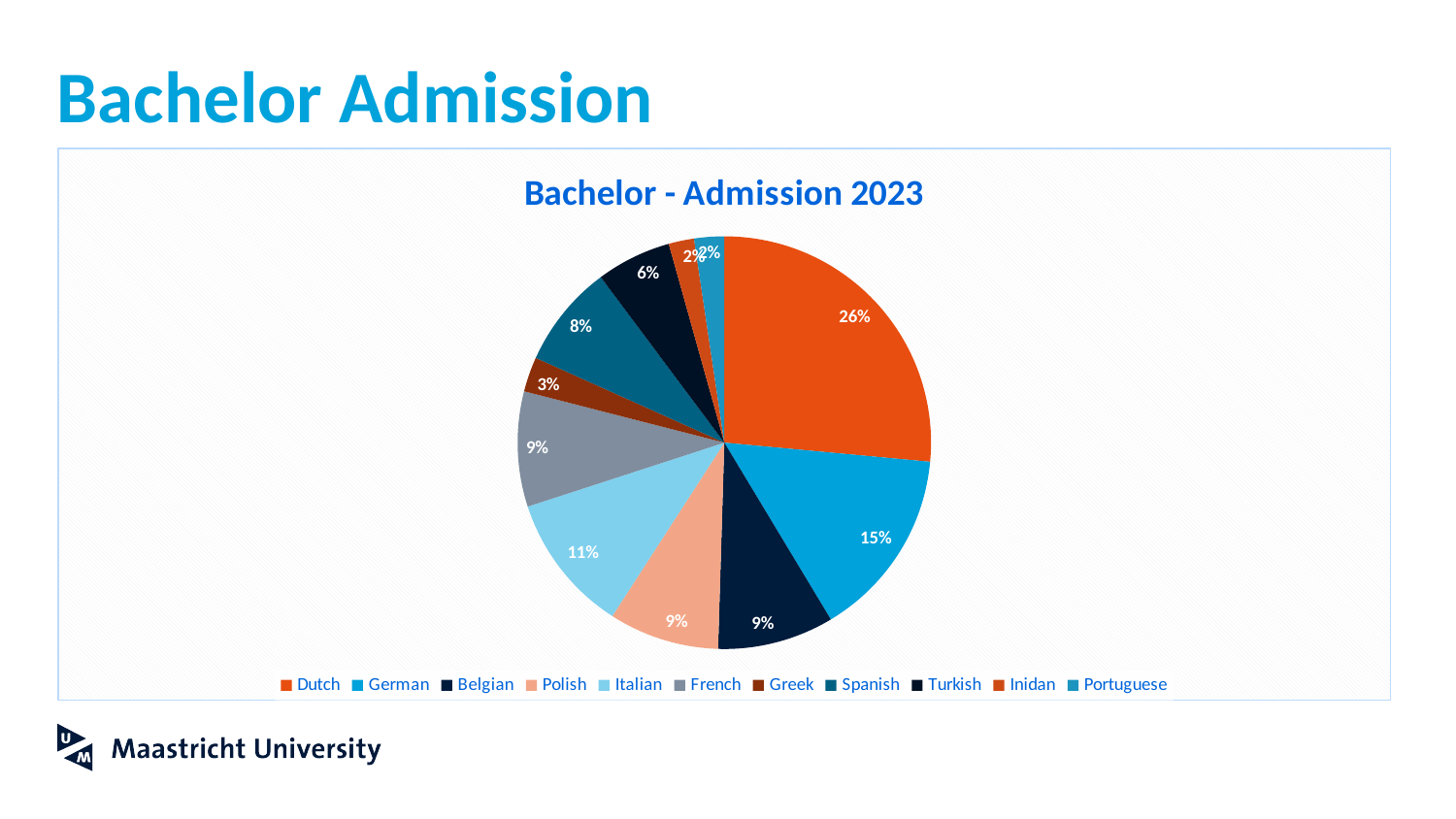
Which is larger, the Italian share or the Spanish share? Italian What share of the pie does German have? 15% What is the difference between the Turkish and Greek shares? 3% Which category has the largest slice of the pie? Dutch What share of the pie does Dutch have? 26% What kind of chart is shown on the slide? Pie chart What is the difference between the Dutch and German shares? 11% What share of the pie does Spanish have? 8% What share of the pie does Italian have? 11% What share of the pie does Greek have? 3% What is the title of the chart? Bachelor - Admission 2023 How many categories does the legend list? 11